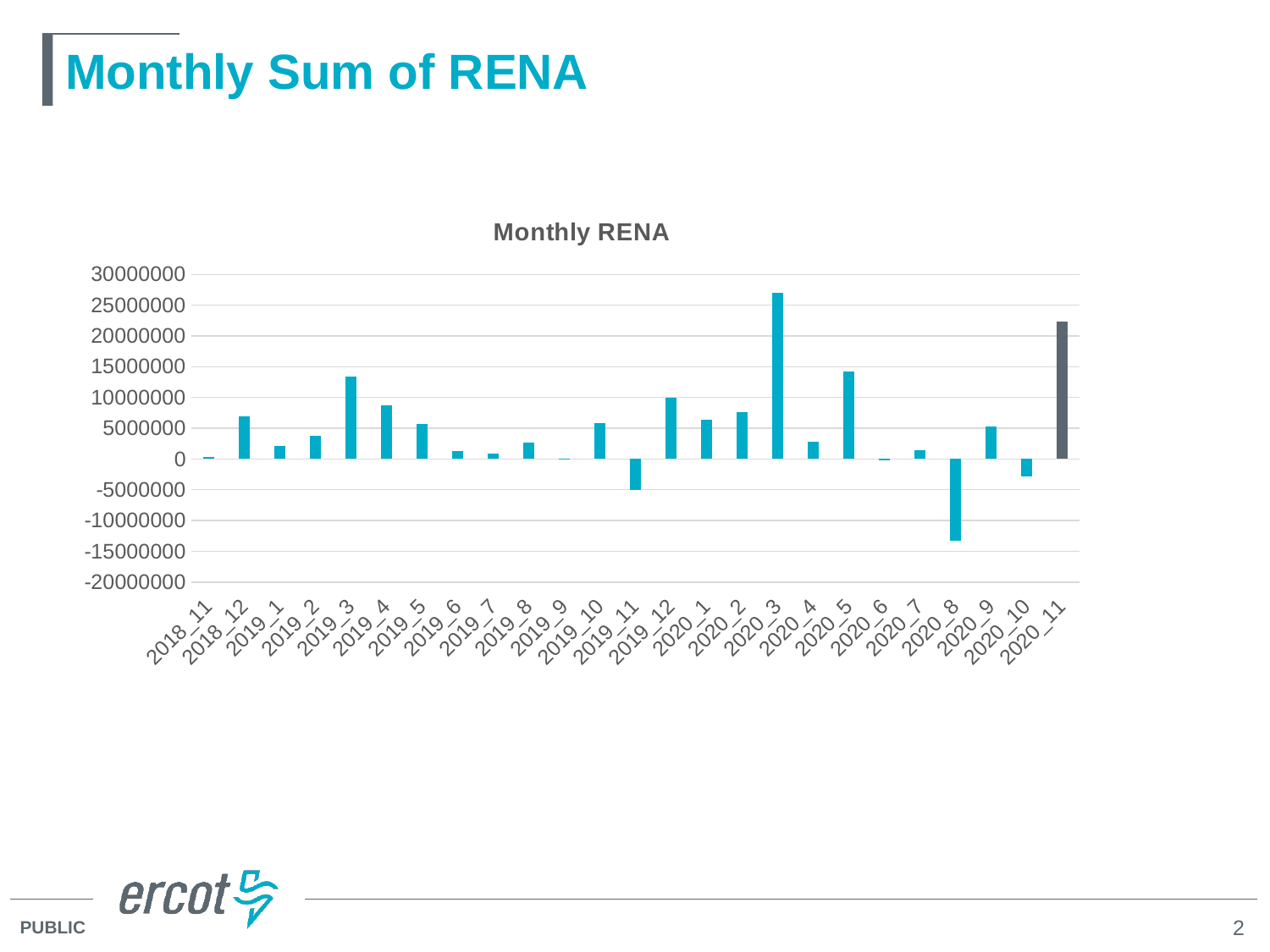
How many months are plotted on the x axis of the Monthly RENA chart? 25 Which month has the larger value, 2018_12 or 2019_1? 2018_12 Which month has the highest Monthly RENA value? 2020_3 Is the value for 2019_11 greater or less than 0? less Is the value for 2020_8 greater or less than -10000000? less What is the title of the chart? Monthly RENA What kind of chart is shown on the slide? bar chart Which month has the larger value, 2020_5 or 2019_12? 2020_5 Is the value for 2020_11 greater or less than 20000000? greater Which month has the lowest Monthly RENA value? 2020_8